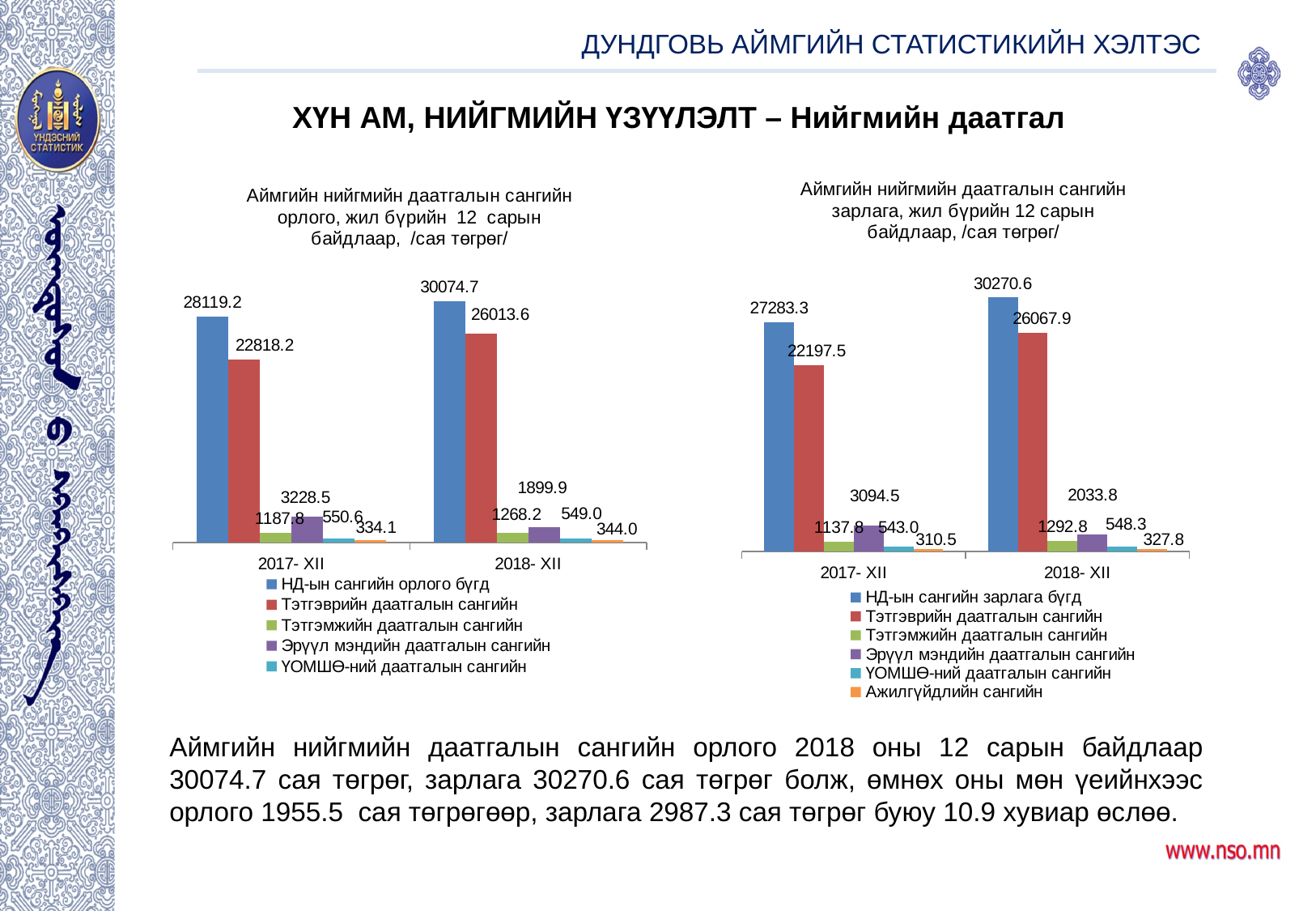
How many time periods (categories) are shown on the x axis of the left chart (орлого)? 2 In the left chart (Аймгийн нийгмийн даатгалын сангийн орлого), what is the value of НД-ын сангийн орлого бүгд for 2018- XII? 30074.7 In the left chart (орлого), which series has the lowest value for 2018- XII? Ажилгүйдлийн сангийн (344.0) How many series does the legend of the right chart (зарлага) list? 6 In the right chart (зарлага), which series has the highest value for 2018- XII? НД-ын сангийн зарлага бүгд What type of chart is the right chart (зарлага)? Bar chart In the right chart (зарлага), what is the value of Эрүүл мэндийн даатгалын сангийн for 2018- XII? 2033.8 In the left chart (орлого), by how much did НД-ын сангийн орлого бүгд increase from 2017- XII to 2018- XII? 1955.5 In the left chart (орлого), what is the value of Тэтгэврийн даатгалын сангийн for 2017- XII? 22818.2 In the right chart (Аймгийн нийгмийн даатгалын сангийн зарлага), what is the value of НД-ын сангийн зарлага бүгд for 2017- XII? 27283.3 In the right chart (зарлага), what is the difference between НД-ын сангийн зарлага бүгд in 2018- XII and 2017- XII? 2987.3 In the left chart (орлого), is Эрүүл мэндийн даатгалын сангийн larger in 2017- XII or 2018- XII? 2017- XII